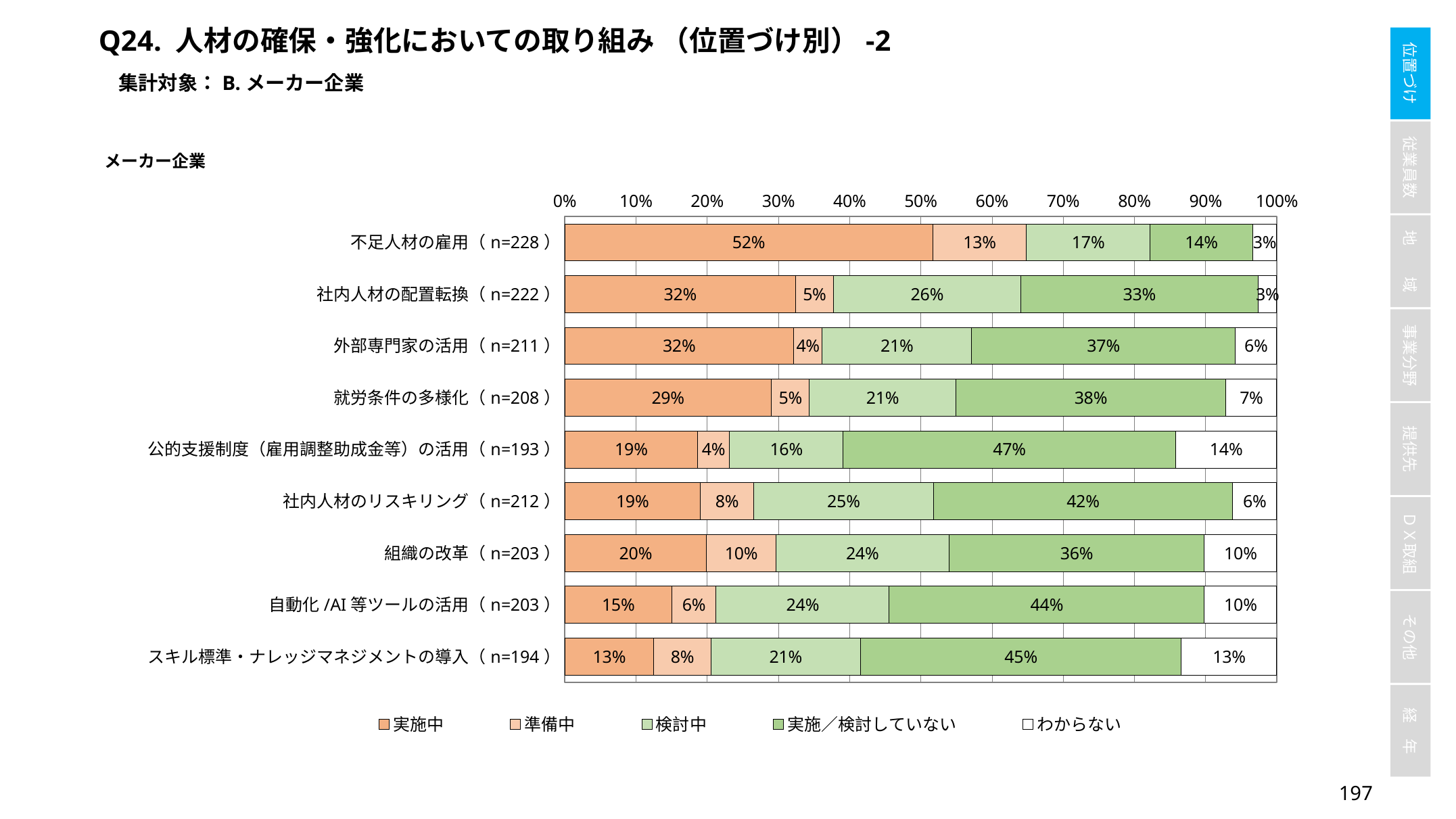
Which category has the lowest 実施中 share? スキル標準・ナレッジマネジメントの導入 Which category has the highest 実施中 share? 不足人材の雇用 What is the わからない value for スキル標準・ナレッジマネジメントの導入? 13% Which has a larger 準備中 share, 組織の改革 or 自動化/AI等ツールの活用? 組織の改革 How many series does the legend list? 5 What is the 実施／検討していない value for 公的支援制度（雇用調整助成金等）の活用? 47% What percentage of respondents are 実施中 for 不足人材の雇用? 52% Which category has the highest 実施／検討していない share? 公的支援制度（雇用調整助成金等）の活用 What is the difference between the 実施中 values for 不足人材の雇用 and 社内人材の配置転換? 20 percentage points What is the 検討中 value for 社内人材の配置転換? 26% What kind of chart is shown on the slide? Stacked bar chart How many categories (取り組み) are shown in the chart? 9